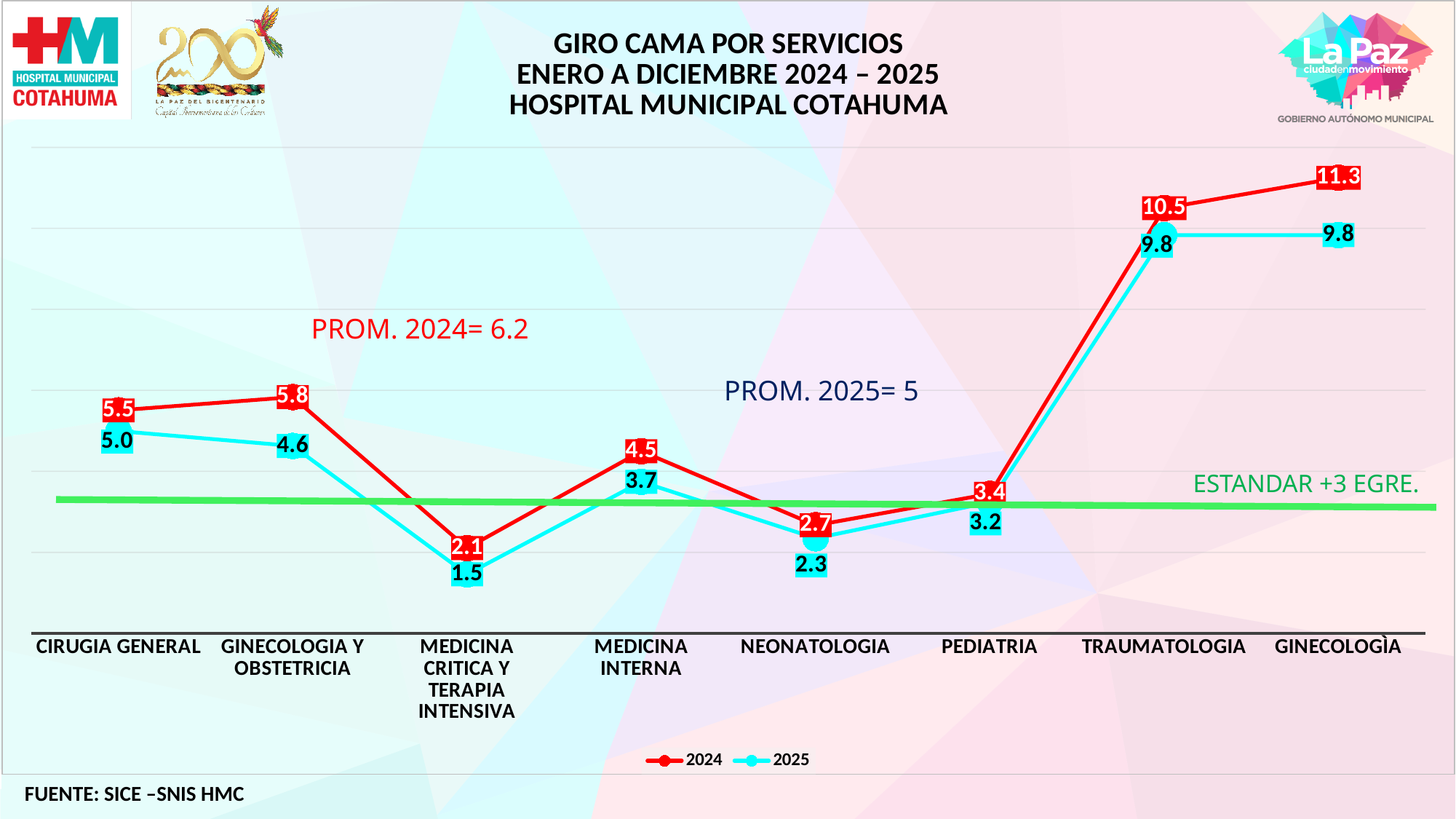
How many series does the legend list? 2 What label is given to the green horizontal reference line? ESTANDAR +3 EGRE. What is the 2025 value for MEDICINA INTERNA? 3.7 Which is larger for GINECOLOGIA Y OBSTETRICIA, the 2024 value or the 2025 value? 2024 What type of chart is shown on the slide? Line chart How many service categories are plotted along the x axis? 8 What average value is shown for 2024 (PROM. 2024)? 6.2 Which category has the lowest 2025 value? MEDICINA CRITICA Y TERAPIA INTENSIVA What is the 2024 value for TRAUMATOLOGIA? 10.5 What is the difference between the 2024 and 2025 values for GINECOLOGÌA? 1.5 What is the 2025 value for NEONATOLOGIA? 2.3 Which category has the highest 2024 value? GINECOLOGÌA